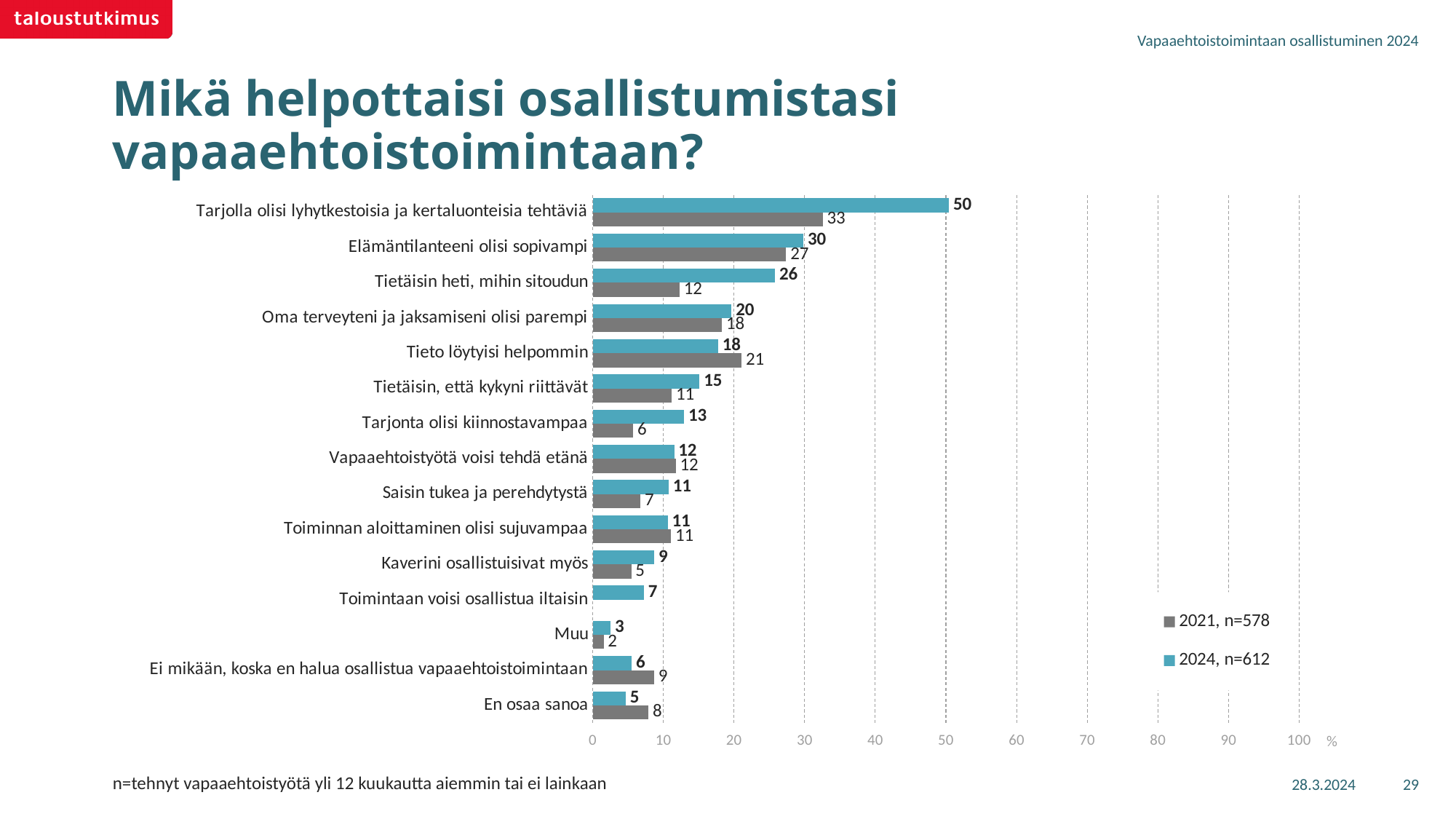
For "Ei mikään, koska en halua osallistua vapaaehtoistoimintaan", which year has the larger value, 2021 or 2024? 2021 What is the difference between the 2024 and 2021 values for "Tarjonta olisi kiinnostavampaa"? 7 What kind of chart is shown on the slide? Bar chart Is the 2024 value for "Elämäntilanteeni olisi sopivampi" greater or less than 20? greater How many series does the legend list? 2 How many categories are shown on the chart? 15 Which category has the lowest 2024 value? Muu What is the 2021 value for "Tieto löytyisi helpommin"? 21 Which category has the highest 2024 value? Tarjolla olisi lyhytkestoisia ja kertaluonteisia tehtäviä What is the 2024 value for "Tarjolla olisi lyhytkestoisia ja kertaluonteisia tehtäviä"? 50 What is the 2021 value for "Tietäisin heti, mihin sitoudun"? 12 What is the difference between the 2024 and 2021 values for "Tarjolla olisi lyhytkestoisia ja kertaluonteisia tehtäviä"? 17